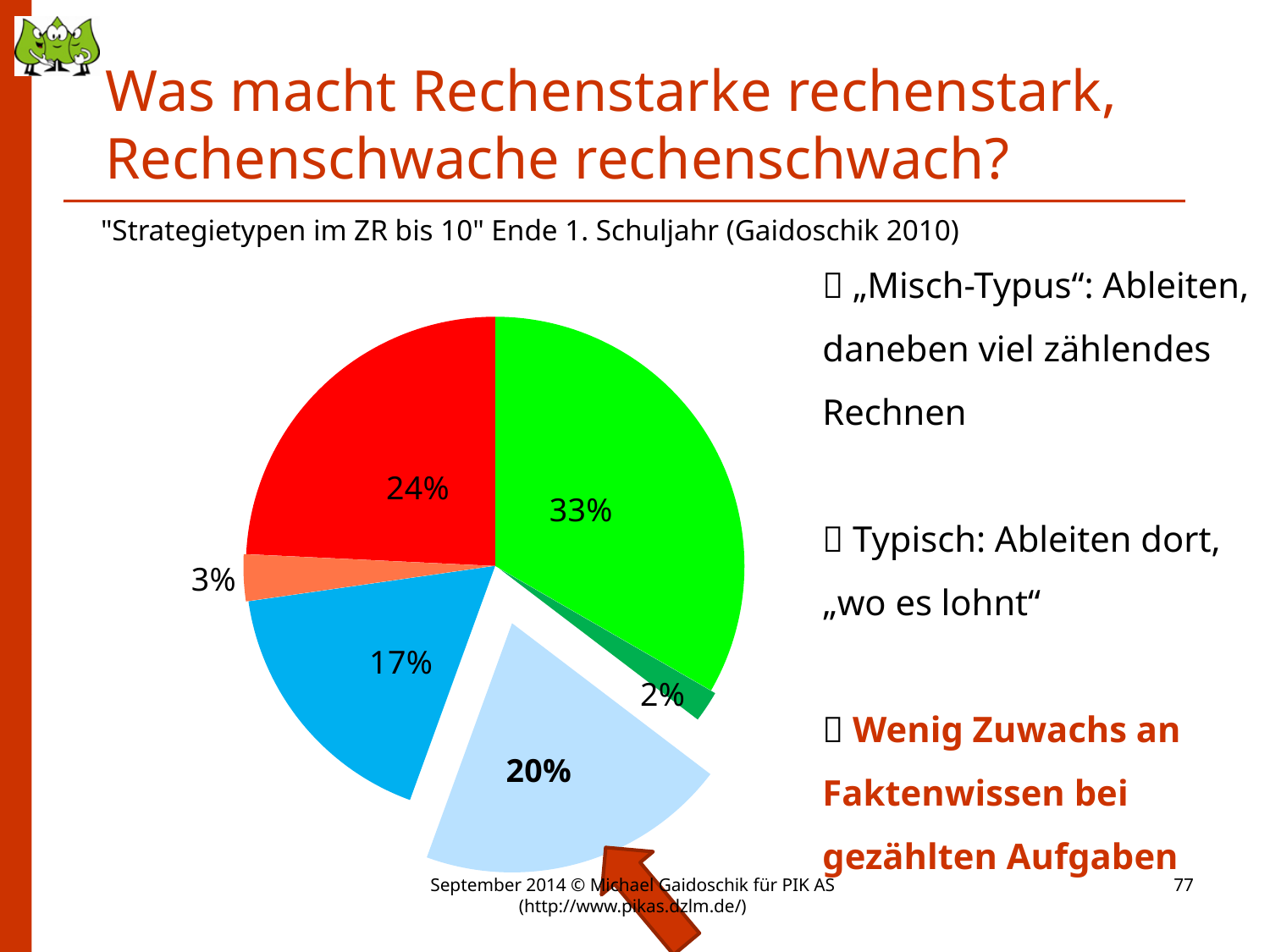
What is the largest share shown in the pie chart? 33% What is the difference in percentage points between the light blue slice (20%) and the dark blue slice (17%)? 3 What is the difference in percentage points between the green slice (33%) and the red slice (24%)? 9 What percentage is shown on the exploded light blue slice of the pie chart? 20% Which slice is larger, the red slice or the dark blue slice? the red slice What percentage is shown on the dark blue slice of the pie chart? 17% What kind of chart is shown on the slide? pie chart Which slice of the pie chart is pulled out (exploded) from the rest? the light blue 20% slice What is the smallest share shown in the pie chart? 2% What percentage is shown on the red slice of the pie chart? 24% What percentage is shown on the bright green slice of the pie chart? 33% How many slices does the pie chart have? 6